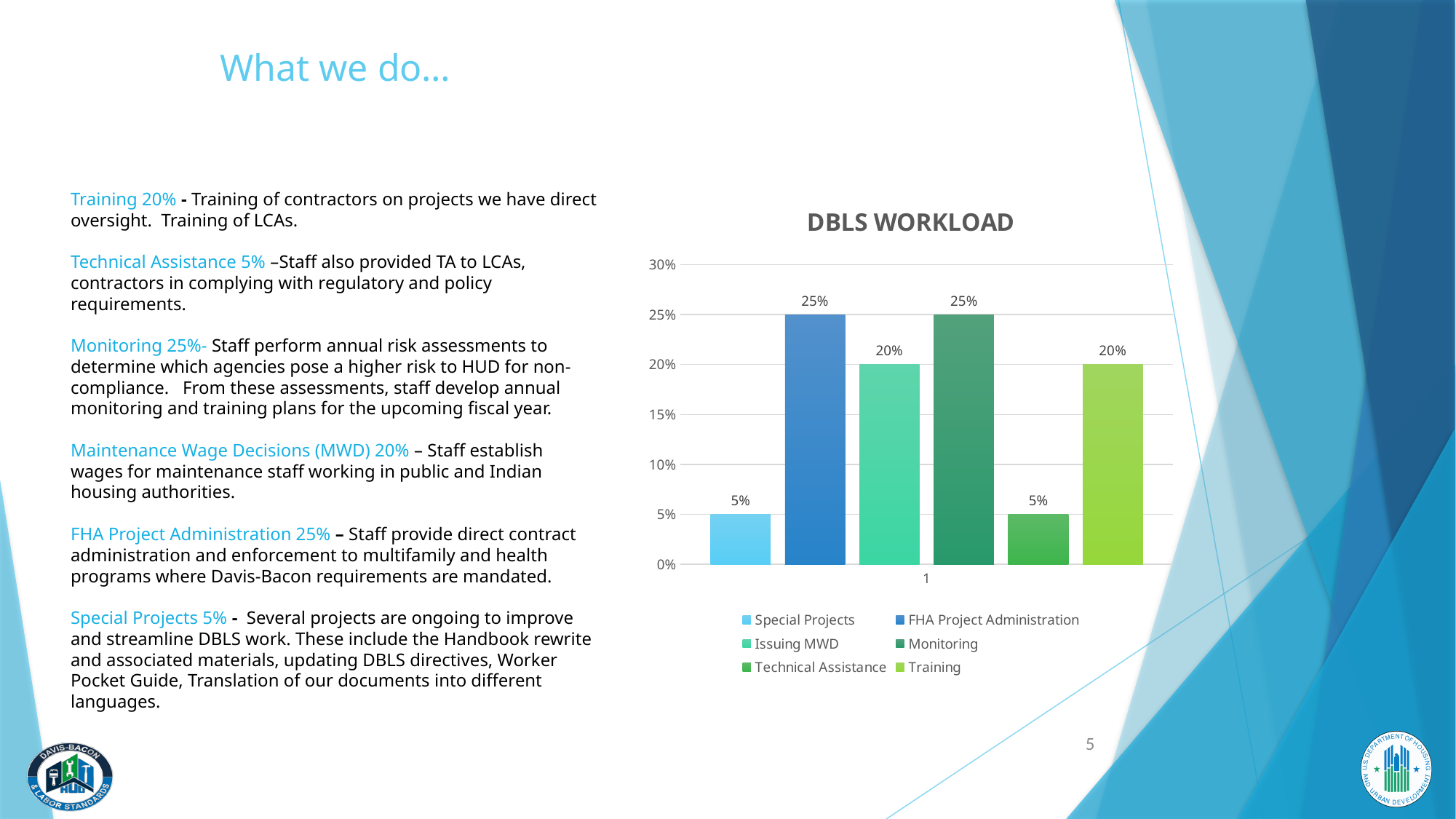
Which series is shown in the lightest blue colour in the legend? Special Projects How many series does the chart legend list? 6 Is the value for Monitoring greater or less than 20%? greater What is the value for Technical Assistance? 5% What is the value for Issuing MWD? 20% What is the difference between the values for Monitoring and Training? 5% Which is larger, the value for Training or the value for Technical Assistance? Training What is the title of the chart? DBLS WORKLOAD What is the difference between the values for FHA Project Administration and Special Projects? 20% What kind of chart is shown on the slide? bar chart What is the value for Special Projects? 5% What is the value for FHA Project Administration? 25%